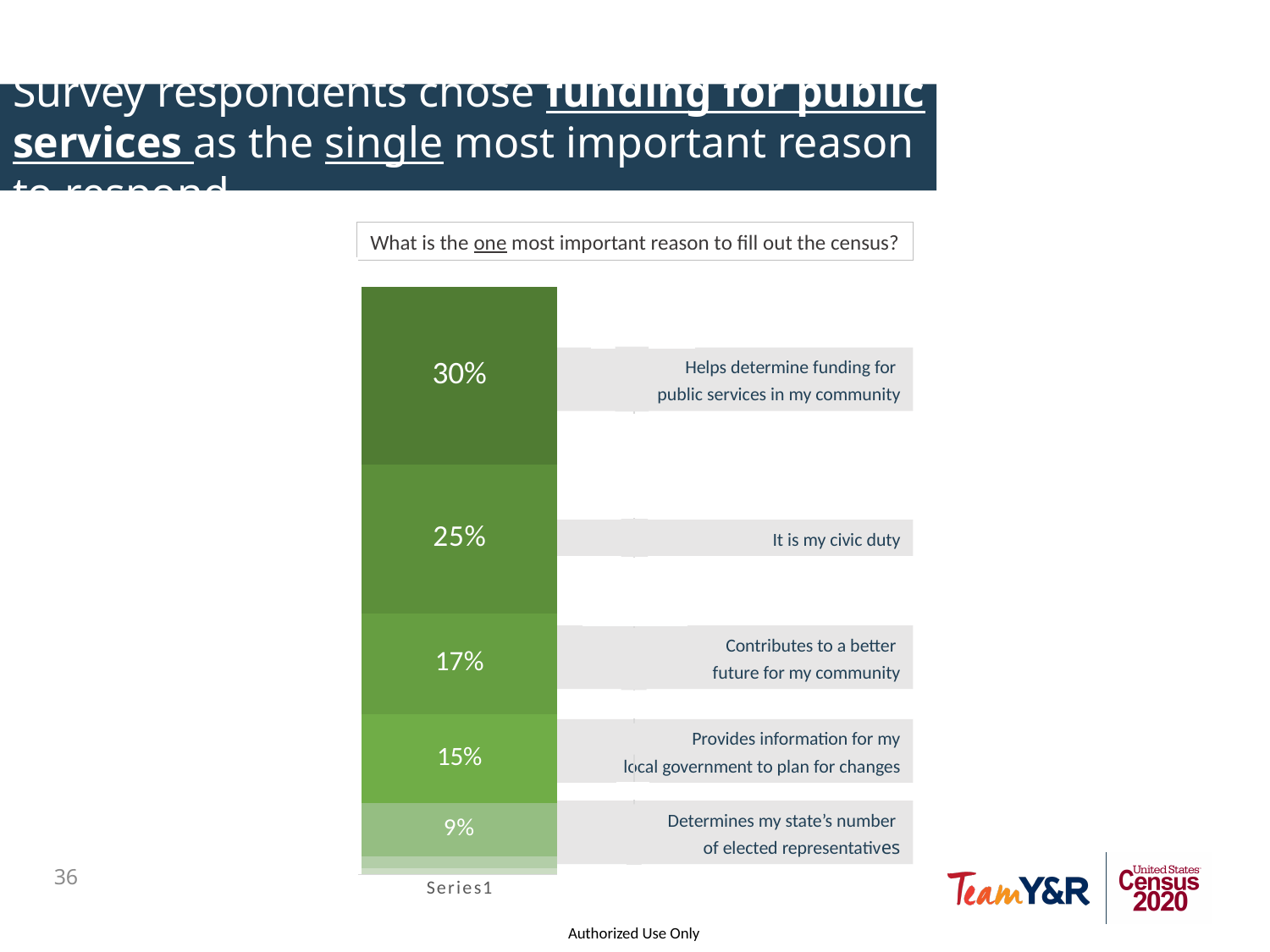
Which labeled reason has the lowest percentage in the chart? Determines my state's number of elected representatives Which has a larger share: "It is my civic duty" or "Provides information for my local government to plan for changes"? It is my civic duty Which reason has the highest percentage in the chart? Helps determine funding for public services in my community What percentage of respondents chose "Helps determine funding for public services in my community" as the most important reason? 30% What percentage of respondents chose "Contributes to a better future for my community"? 17% What is the difference in percentage points between "Helps determine funding for public services in my community" and "It is my civic duty"? 5 What percentage of respondents chose "Provides information for my local government to plan for changes"? 15% What kind of chart is shown on the slide? Stacked bar chart What survey question is shown above the chart? What is the one most important reason to fill out the census? What percentage of respondents chose "Determines my state's number of elected representatives"? 9% What percentage of respondents chose "It is my civic duty"? 25% What is the difference in percentage points between "Contributes to a better future for my community" and "Determines my state's number of elected representatives"? 8